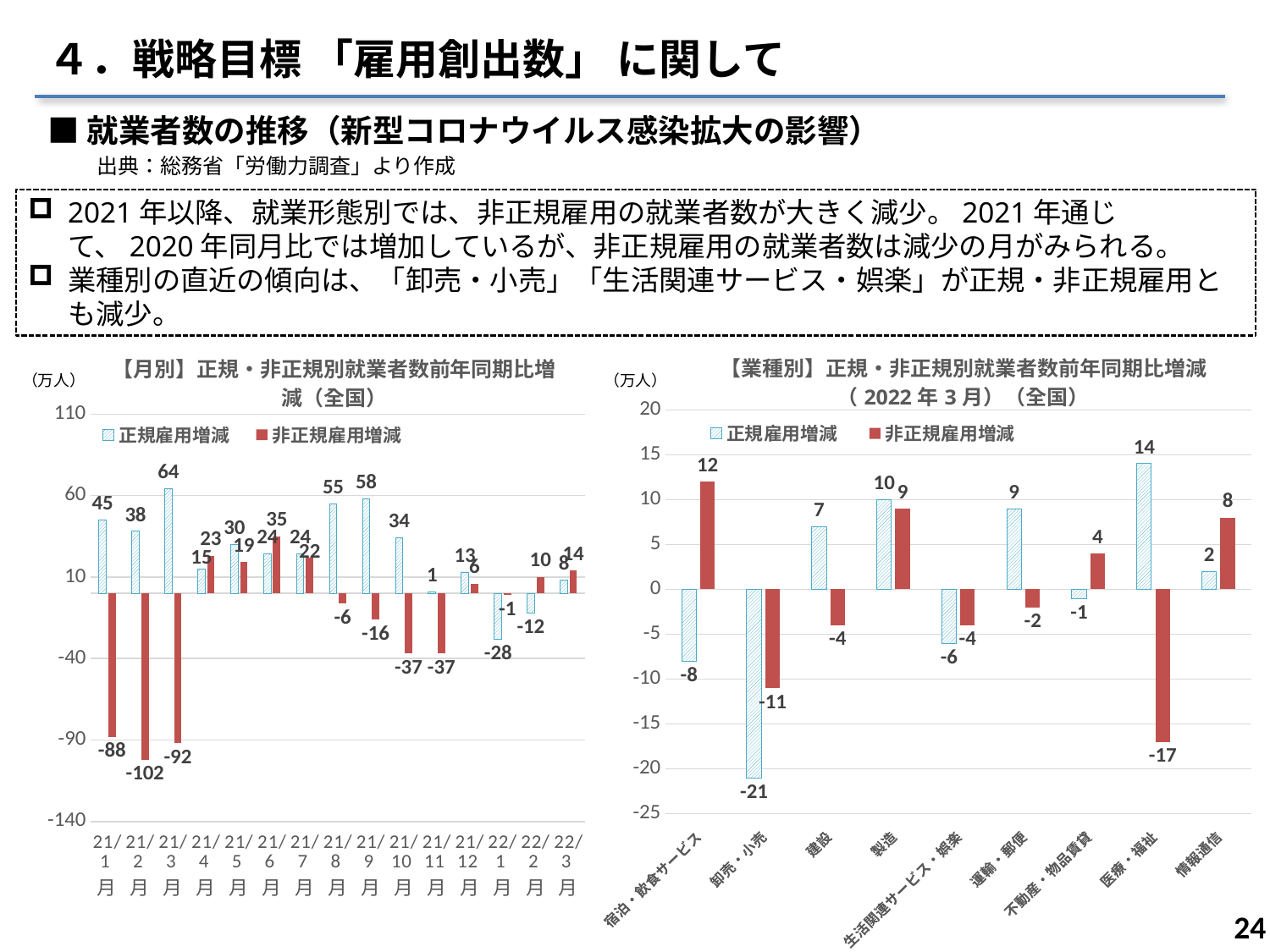
In the left chart (【月別】), which month has the lowest value of 非正規雇用増減? 21/2月 In the left chart (【月別】), what is the value of 非正規雇用増減 for 21/2月? -102 How many months are shown on the x axis of the left chart (【月別】)? 15 In the right chart (【業種別】), what is the value of 非正規雇用増減 for 医療・福祉? -17 How many series does the legend of the left chart (【月別】) list? 2 In the right chart (【業種別】), which industry has the highest value of 正規雇用増減? 医療・福祉 In the left chart (【月別】), what is the value of 正規雇用増減 for 21/3月? 64 In the right chart (【業種別】), which is larger for 製造: 正規雇用増減 or 非正規雇用増減? 正規雇用増減 In the right chart (【業種別】), what is the value of 正規雇用増減 for 卸売・小売? -21 What type of chart is the right chart (【業種別】)? Bar chart How many industries are shown on the x axis of the right chart (【業種別】)? 9 In the right chart (【業種別】), what is the difference between 非正規雇用増減 for 宿泊・飲食サービス and for 情報通信? 4